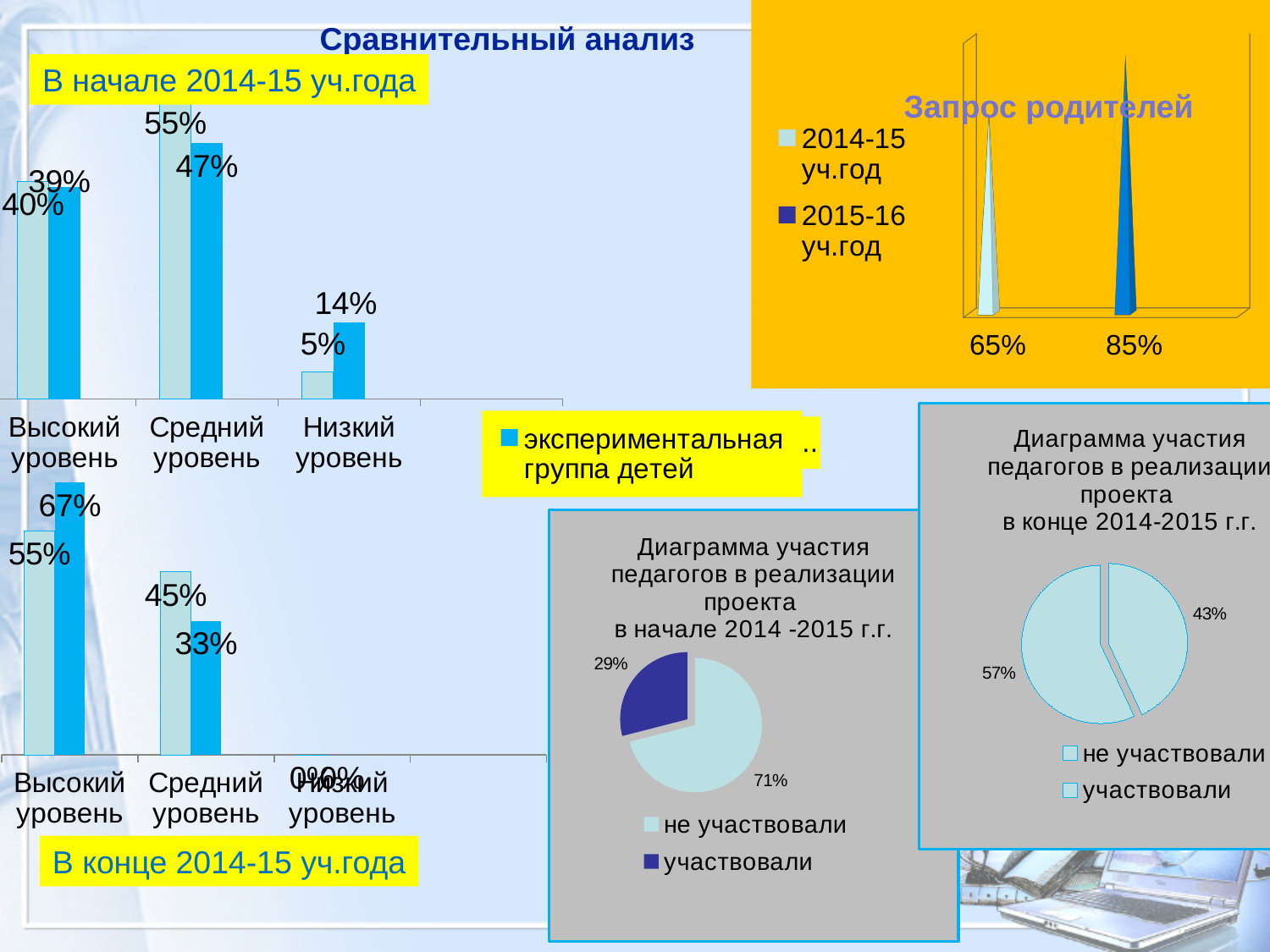
What kind of chart is 'Диаграмма участия педагогов в реализации проекта в конце 2014-2015 г.г.'? pie chart In the pie chart 'Диаграмма участия педагогов в реализации проекта в начале 2014-2015 г.г.', what share is 'участвовали'? 29% In the 'Запрос родителей' chart, what is the difference between the 2015-16 уч.год and 2014-15 уч.год values? 20% In the bar chart 'В начале 2014-15 уч.года', what is the value of the dark blue bar for Низкий уровень? 14% In the bar chart 'В конце 2014-15 уч.года', which category has the lowest values? Низкий уровень In the 'Запрос родителей' chart, what is the value for 2015-16 уч.год? 85% How many series does the legend of the 'Запрос родителей' chart list? 2 In the bar chart 'В конце 2014-15 уч.года', what is the value of the dark blue bar for Высокий уровень? 67% In the bar chart 'В начале 2014-15 уч.года', what is the value of the dark blue bar for Средний уровень? 47% In the 'Запрос родителей' chart, what is the value for 2014-15 уч.год? 65% In the pie chart 'Диаграмма участия педагогов в реализации проекта в начале 2014-2015 г.г.', what share is 'не участвовали'? 71% In the pie chart 'Диаграмма участия педагогов в реализации проекта в конце 2014-2015 г.г.', what is the share of the larger slice? 57%